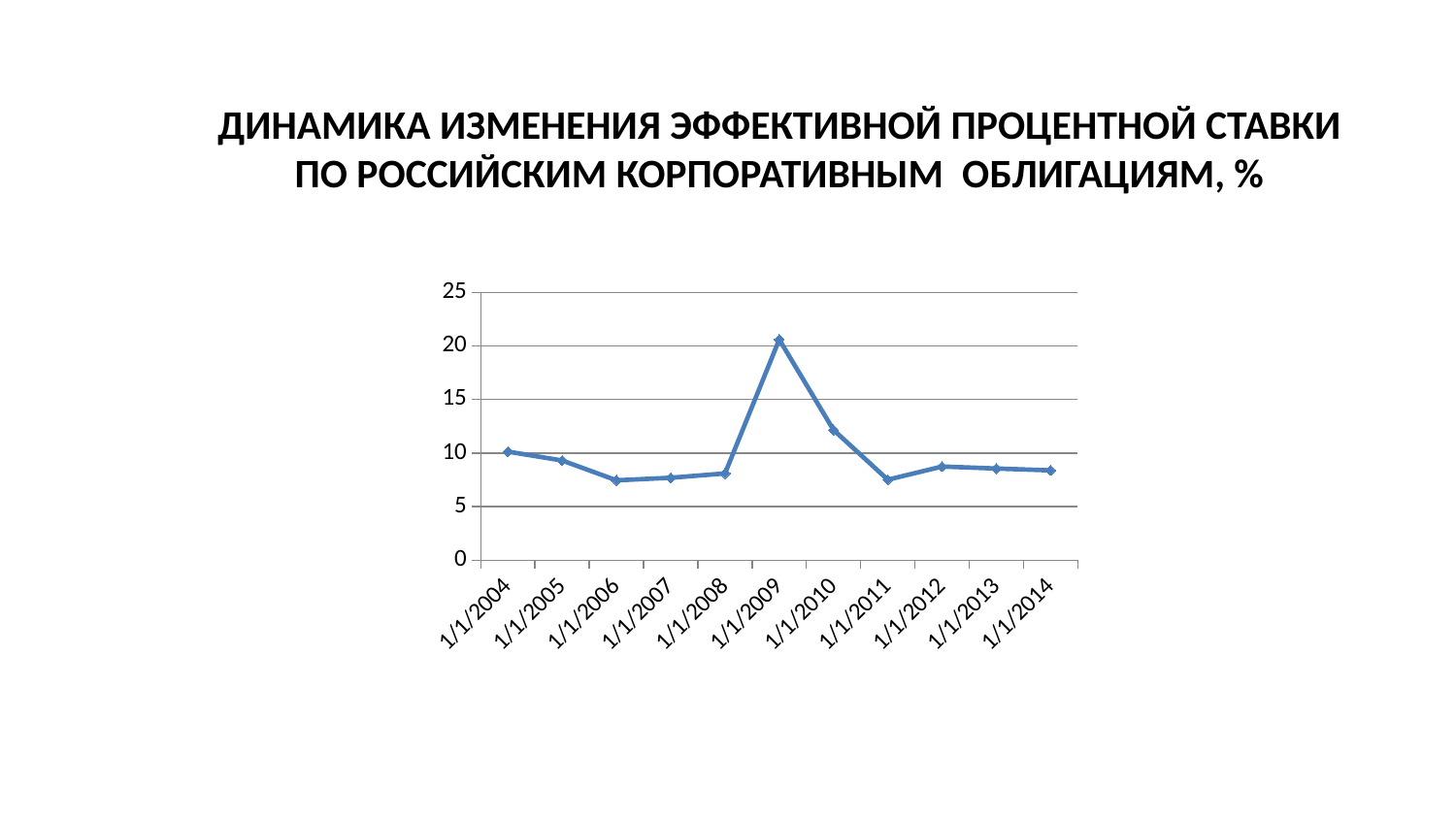
Is the value for 1/1/2006 greater or less than 10? less Is the value for 1/1/2009 greater or less than 20? greater Which date has the highest value on the chart? 1/1/2009 Is the value for 1/1/2008 greater or less than 5? greater Which is larger, the value for 1/1/2010 or the value for 1/1/2011? 1/1/2010 How many data points are plotted on the line? 11 Do the values rise or fall from 1/1/2009 to 1/1/2011? fall Which is larger, the value for 1/1/2009 or the value for 1/1/2010? 1/1/2009 What kind of chart is shown on the slide? line chart What is the first date shown on the x axis? 1/1/2004